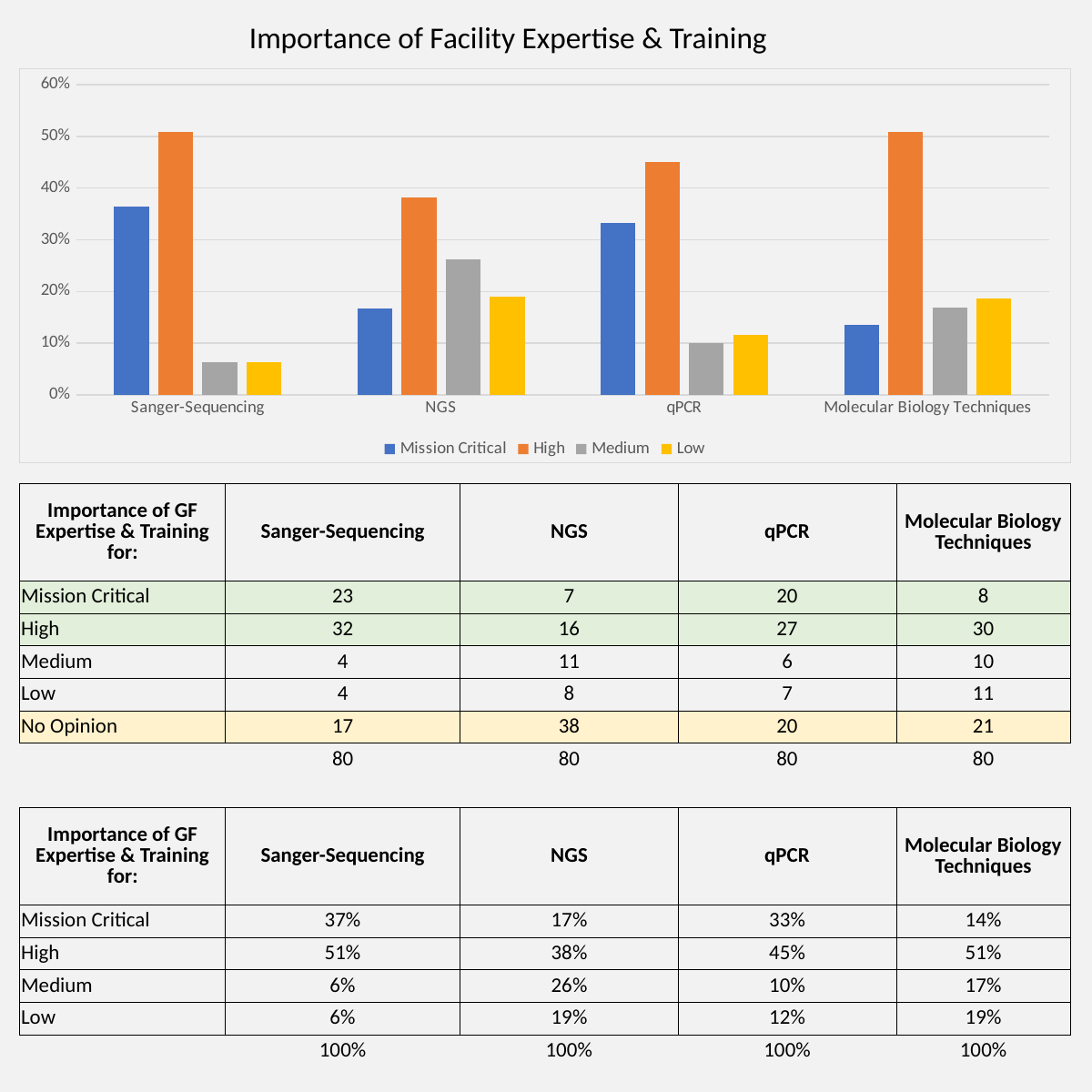
Which category has the highest Medium value? NGS Which series is shown in orange in the chart? High What is the value of the High series for qPCR? 45% Is the Low value for Sanger-Sequencing greater or less than 10%? less How many categories are shown on the x axis of the chart? 4 How many series does the chart legend list? 4 What is the value of the Mission Critical series for Sanger-Sequencing? 37% What kind of chart is shown on the slide? bar chart Is the High value for NGS greater or less than 30%? greater What is the difference between the High and Mission Critical values for qPCR? 12% Which category has the lowest Mission Critical value? Molecular Biology Techniques What is the title of the chart? Importance of Facility Expertise & Training